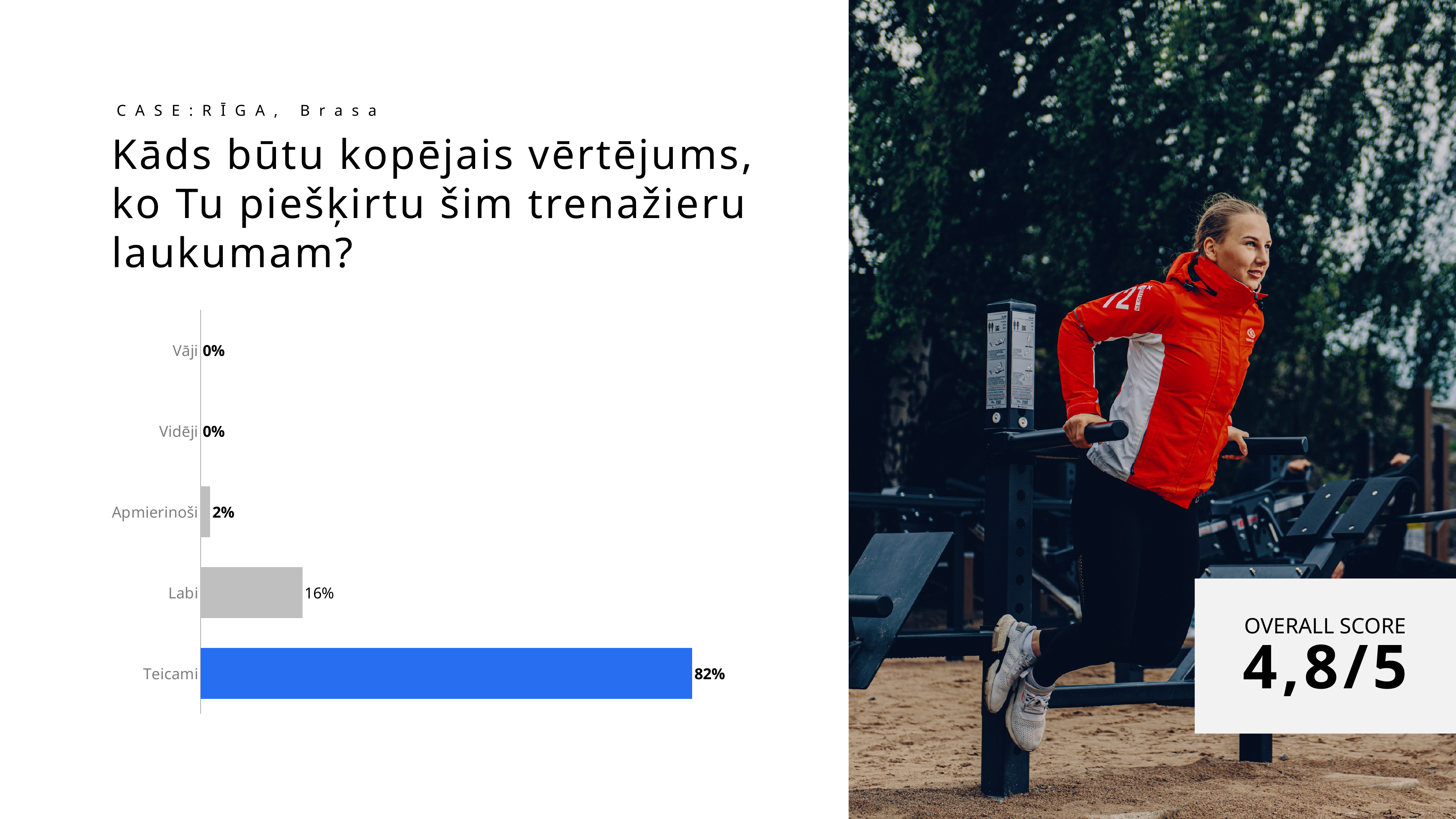
What is the difference between the values for Labi and Apmierinoši? 14% What is the value for Teicami? 82% How many categories have a value of 0%? 2 What is the value for Vāji? 0% What is the value for Labi? 16% How many categories are shown in the chart? 5 Which is larger, the value for Labi or the value for Apmierinoši? Labi What is the value for Apmierinoši? 2% What kind of chart is shown on the slide? Bar chart Which bar in the chart is coloured blue? Teicami Which category has the highest value? Teicami What is the difference between the values for Teicami and Labi? 66%